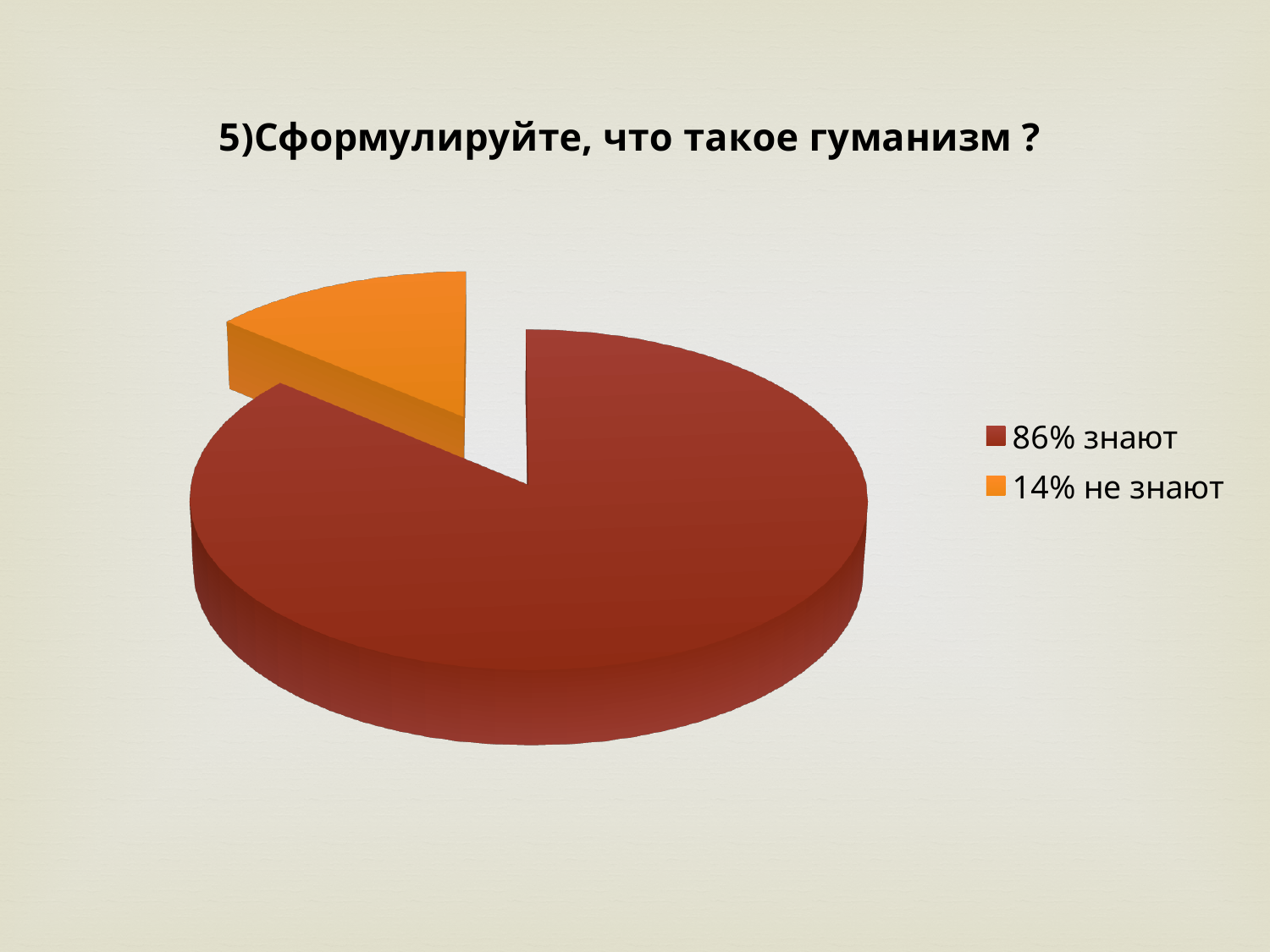
What share of the pie is taken by the slice for those who do not know (не знают)? 14% What is the difference in percentage points between the 'знают' slice and the 'не знают' slice? 72 Which slice is the smallest in the pie chart? 14% не знают What colour is the slice for 'не знают'? orange What is the total of the two slices shown in the legend? 100% What is the title of the chart? 5)Сформулируйте, что такое гуманизм ? How many entries does the legend list? 2 Which is larger: the 'знают' slice or the 'не знают' slice? знают What kind of chart is shown on the slide? pie chart What share of the pie is taken by the slice for those who know (знают)? 86% Which slice is the largest in the pie chart? 86% знают How many slices does the pie chart have? 2